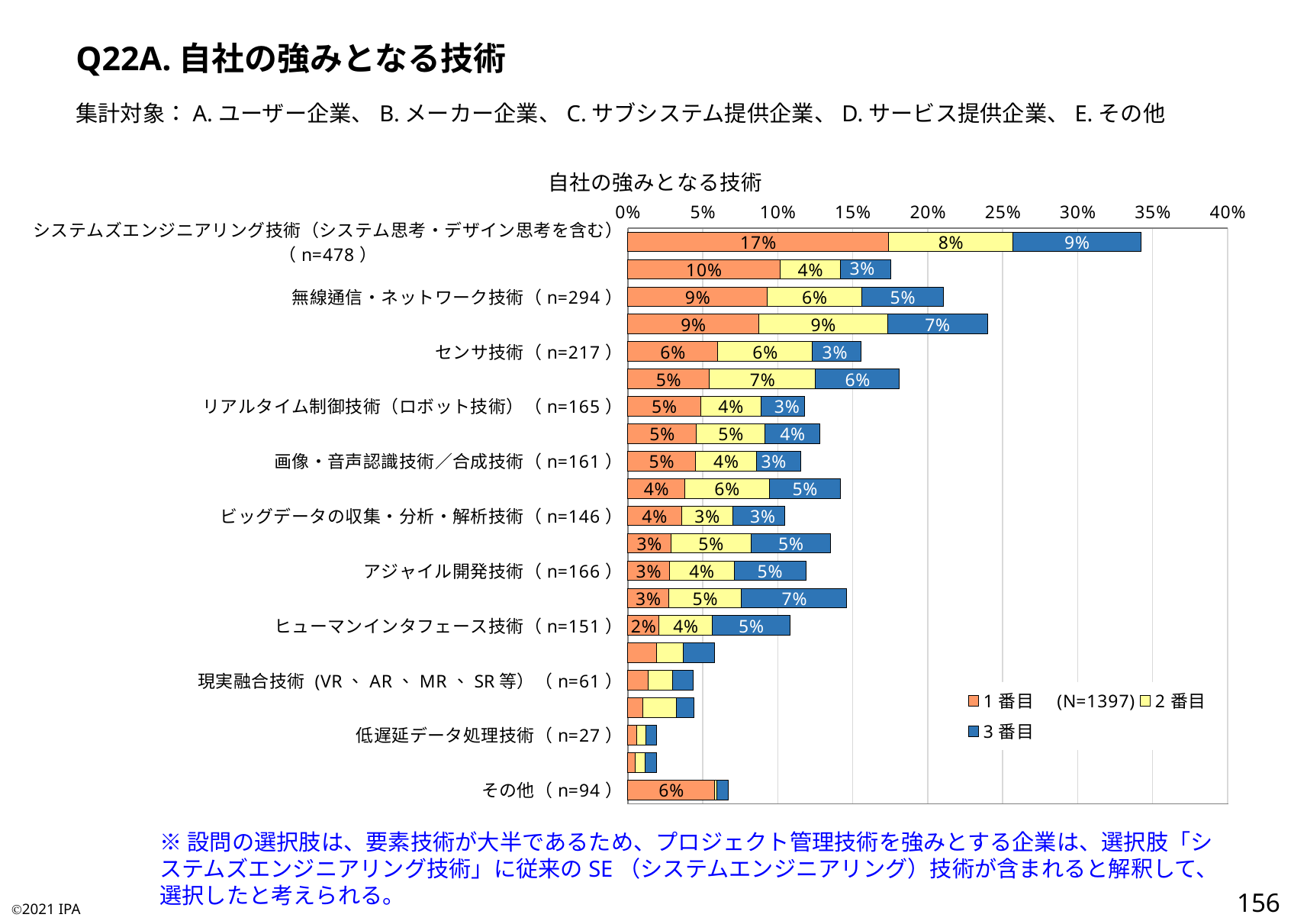
What kind of chart is shown on the slide? Stacked bar chart How many series does the legend list? 3 What is the total of the stacked bar for システムズエンジニアリング技術（システム思考・デザイン思考を含む）? 34% What is the 3番目 value for 無線通信・ネットワーク技術? 5% What is the 1番目 value for その他? 6% Which labeled category has the highest 1番目 value? システムズエンジニアリング技術（システム思考・デザイン思考を含む） What is the 1番目 value for システムズエンジニアリング技術（システム思考・デザイン思考を含む）? 17% What is the 2番目 value for ヒューマンインタフェース技術? 4% Which has the larger 1番目 value, センサ技術 or アジャイル開発技術? センサ技術 Is the total bar length for 低遅延データ処理技術 greater or less than 5%? less What is the total of the stacked bar for 無線通信・ネットワーク技術? 20% What is the difference between the 1番目 values for システムズエンジニアリング技術 and 無線通信・ネットワーク技術? 8 percentage points